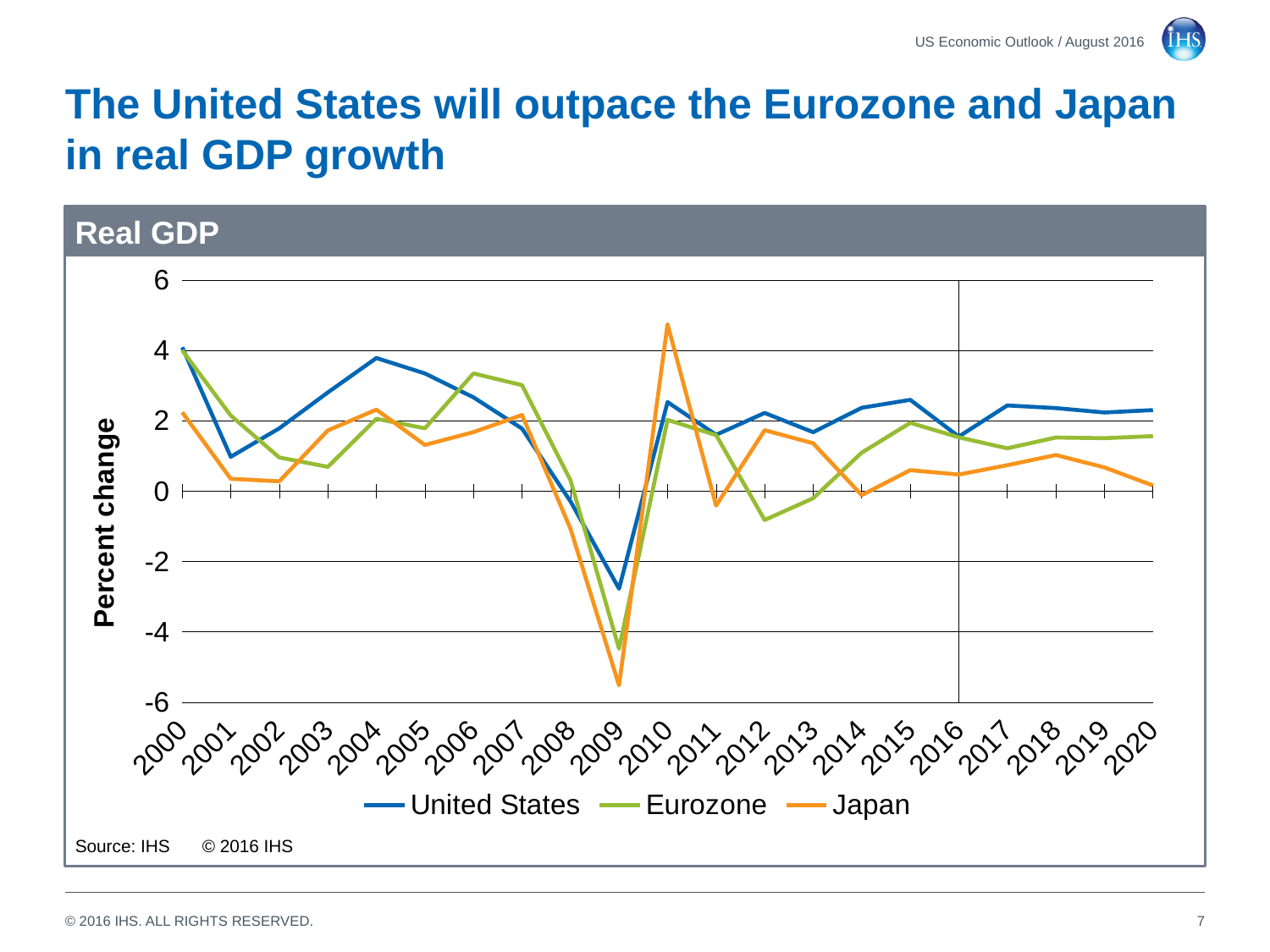
In which year does the Japan series reach its highest value? 2010 How many series does the legend list? 3 Is the value for the United States in 2009 greater or less than -2? less In which year does the United States series reach its lowest value? 2009 In which year does the Japan series reach its lowest value? 2009 In 2020, which series has the higher value, United States or Japan? United States What kind of chart is shown on the slide? line chart What is the label on the y axis? Percent change In 2009, which series has the lower value, United States or Japan? Japan Is the value for Japan in 2010 greater or less than 4? greater Is the value for the Eurozone in 2012 greater or less than 0? less How many years are plotted along the x axis? 21